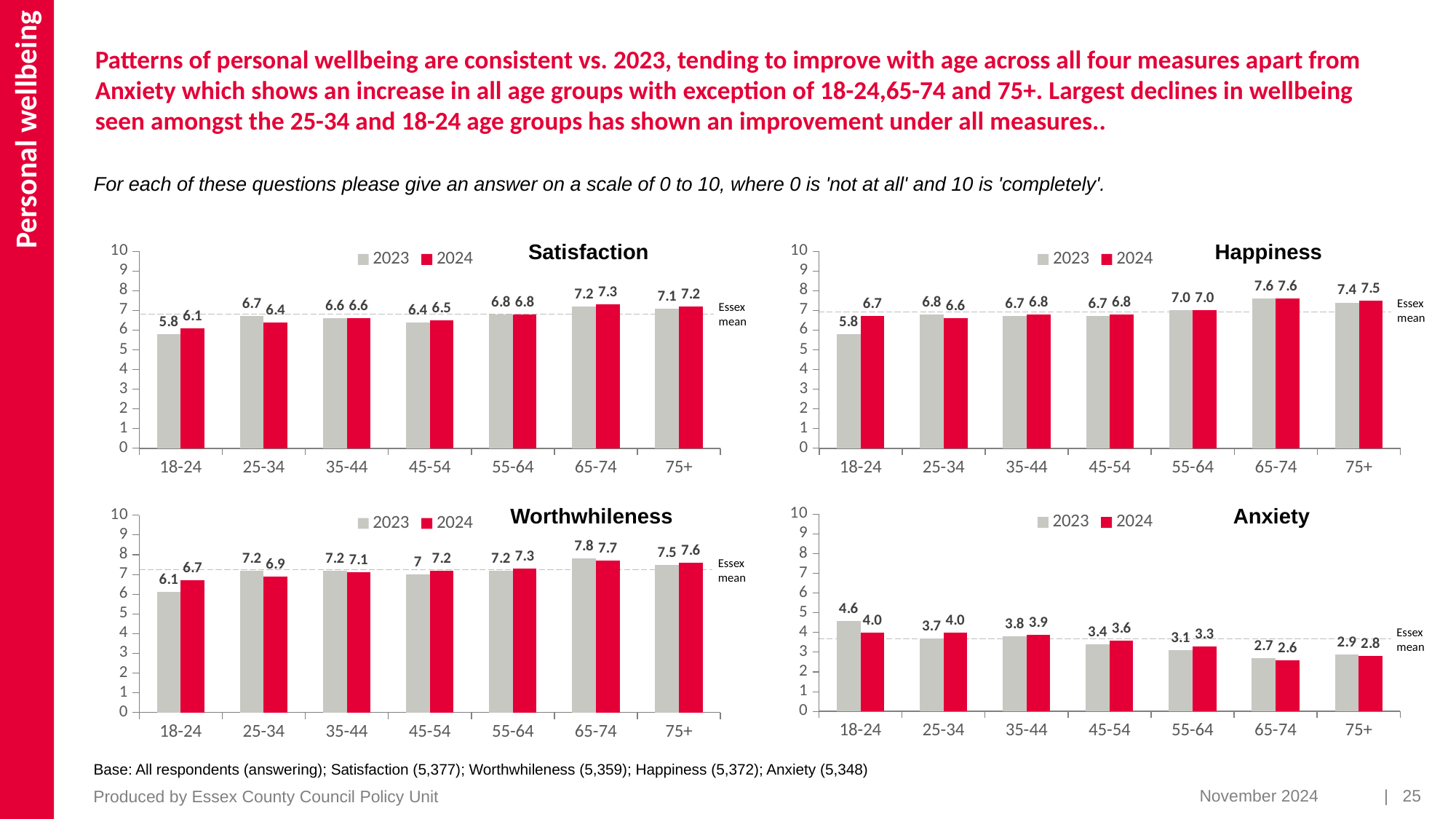
In the Anxiety chart, which age group has the highest 2023 value? 18-24 In the Satisfaction chart, what is the 2024 value for the 18-24 age group? 6.1 In the Satisfaction chart, which is larger for the 25-34 age group: the 2023 value or the 2024 value? 2023 In the Anxiety chart, what is the difference between the 2023 and 2024 values for the 18-24 age group? 0.6 In the Happiness chart, what is the 2023 value for the 65-74 age group? 7.6 What kind of chart is the Satisfaction chart? Bar chart In the Worthwhileness chart, is the 2024 value for the 65-74 age group greater or less than 7? greater In the Worthwhileness chart, which age group has the lowest 2024 value? 18-24 What does the dashed horizontal line on each chart represent? Essex mean How many series does the legend of the Anxiety chart list? 2 How many age groups are shown on the x axis of the Happiness chart? 7 In the Anxiety chart, do the 2023 values generally rise or fall from the 18-24 age group to the 65-74 age group? Fall